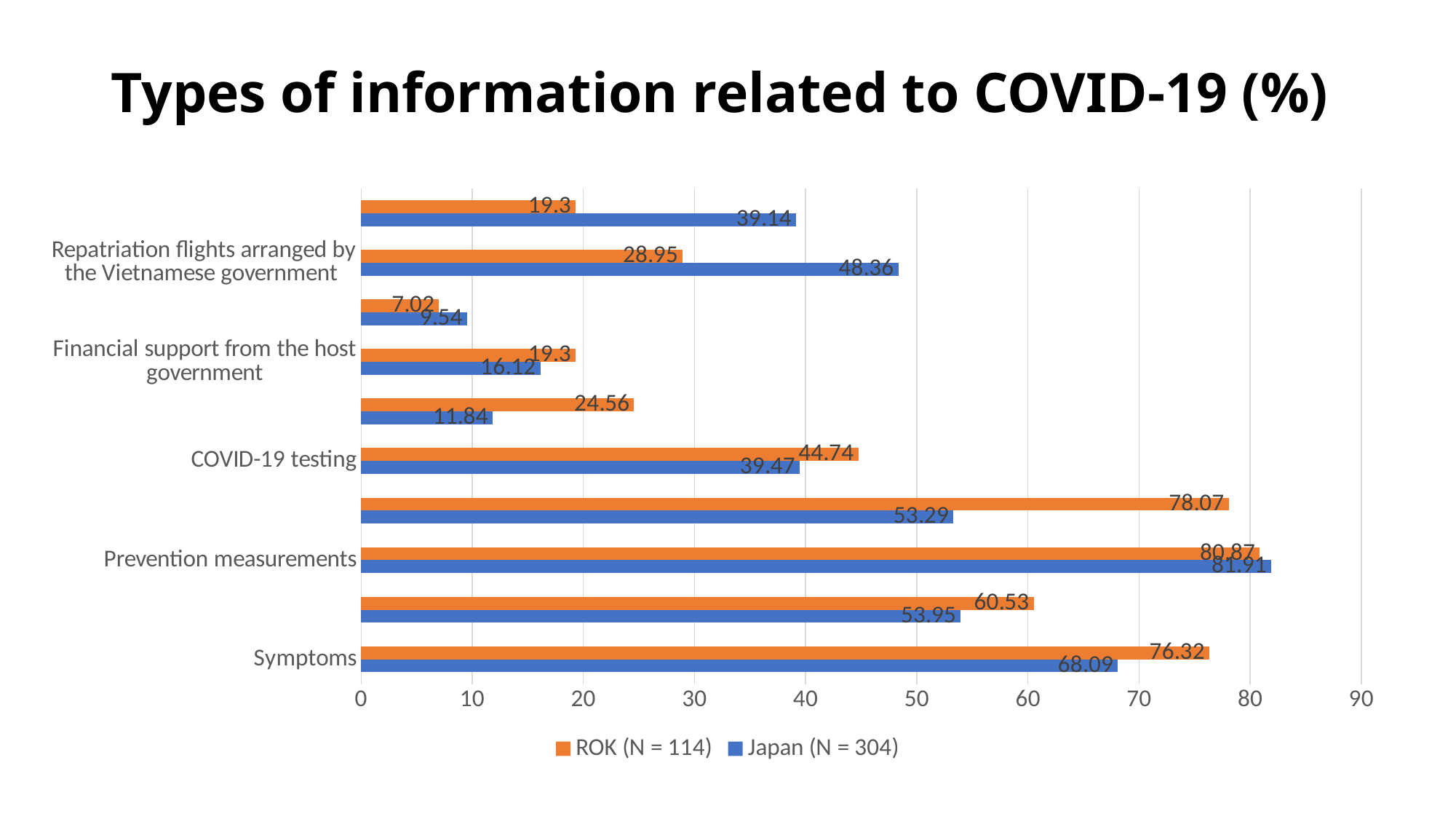
For Symptoms, how much larger is the ROK (N = 114) value than the Japan (N = 304) value? 8.23 What kind of chart is shown on the slide? Bar chart How many series does the legend list? 2 What is the ROK (N = 114) value for Financial support from the host government? 19.3 What is the Japan (N = 304) value for COVID-19 testing? 39.47 What is the title of the chart? Types of information related to COVID-19 (%) What is the ROK (N = 114) value for Symptoms? 76.32 For Prevention measurements, which series has the larger value, ROK (N = 114) or Japan (N = 304)? Japan (N = 304) Is the Japan (N = 304) value for Financial support from the host government greater or less than 20? less What is the Japan (N = 304) value for Repatriation flights arranged by the Vietnamese government? 48.36 For COVID-19 testing, what is the difference between the ROK (N = 114) and Japan (N = 304) values? 5.27 For Repatriation flights arranged by the Vietnamese government, what is the difference between the Japan (N = 304) and ROK (N = 114) values? 19.41